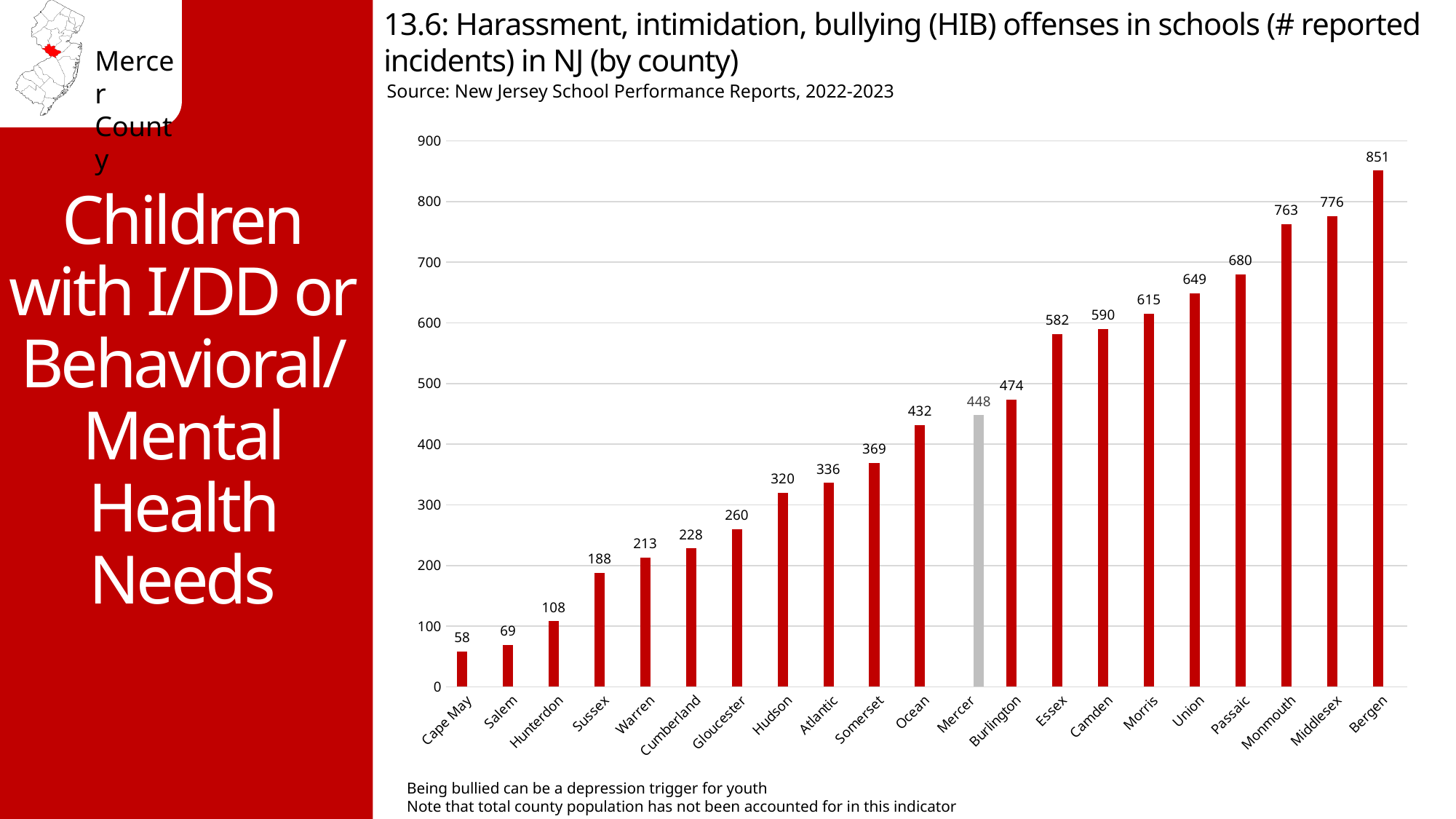
Which county has the lowest number of reported HIB incidents? Cape May Do the values rise or fall from left to right along the x axis? Rise What is the number of reported HIB incidents for Hudson County? 320 Which county's bar is coloured grey instead of red? Mercer What is the number of reported HIB incidents for Mercer County? 448 What is the difference in reported HIB incidents between Bergen and Mercer? 403 Which county has the highest number of reported HIB incidents? Bergen What is the difference in reported HIB incidents between Middlesex and Monmouth? 13 How many counties are shown on the chart? 21 Is the value for Passaic greater or less than 700? less What kind of chart is shown on the slide? Bar chart Which county has more reported HIB incidents, Essex or Camden? Camden